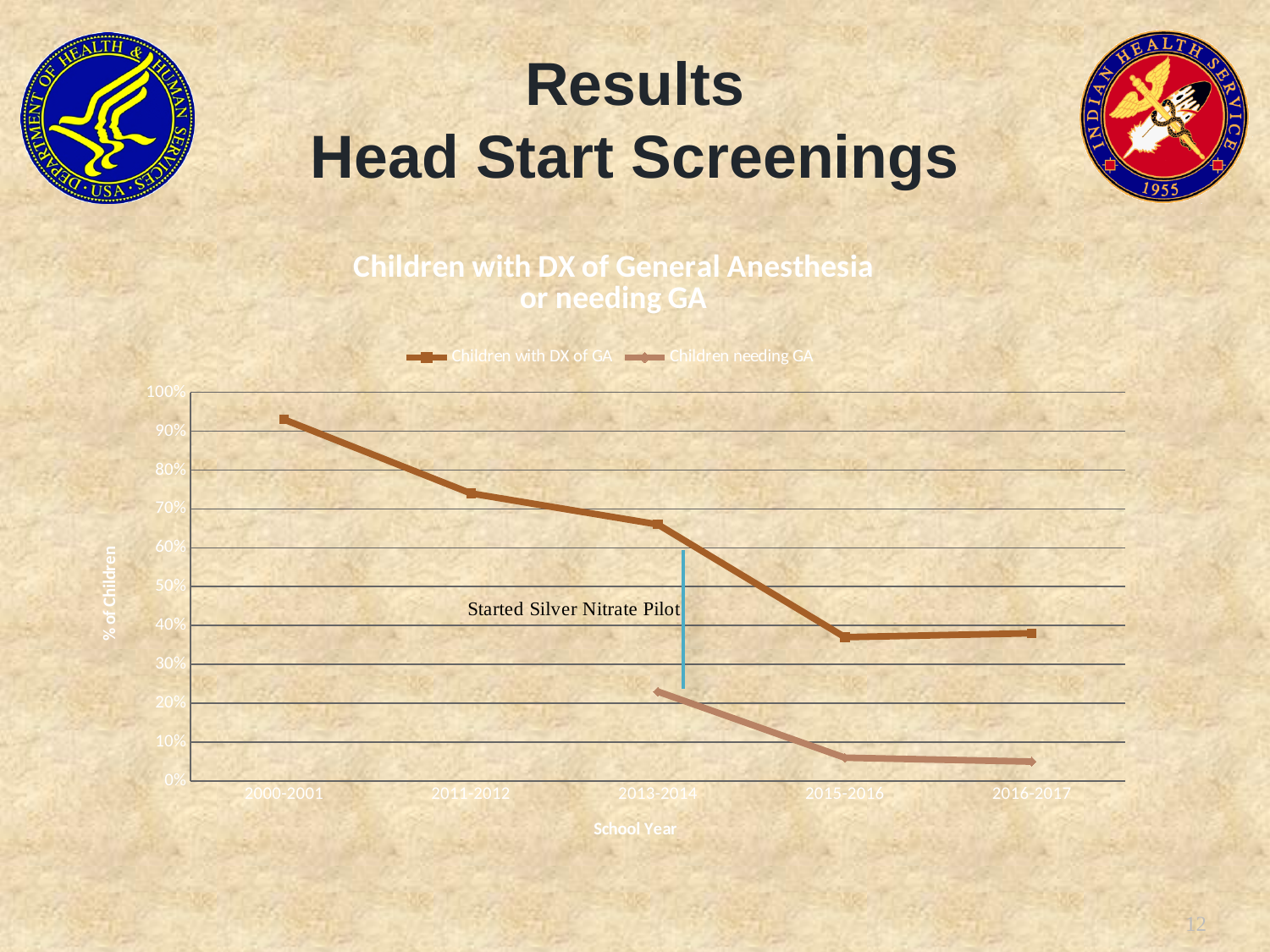
What event does the annotation on the chart mark? Started Silver Nitrate Pilot Is the value for Children with DX of GA in 2015-2016 greater or less than 40%? less Does the value for Children with DX of GA rise or fall from 2000-2001 to 2015-2016? Fall Is the value for Children with DX of GA in 2000-2001 greater or less than 80%? greater How many school years are shown on the x axis? 5 Is the value for Children with DX of GA in 2013-2014 greater or less than 70%? less In which school year is the value for Children needing GA highest? 2013-2014 What kind of chart is shown on the slide? Line chart In which school year is the value for Children with DX of GA highest? 2000-2001 In 2013-2014, which series has the larger value: Children with DX of GA or Children needing GA? Children with DX of GA How many series does the legend list? 2